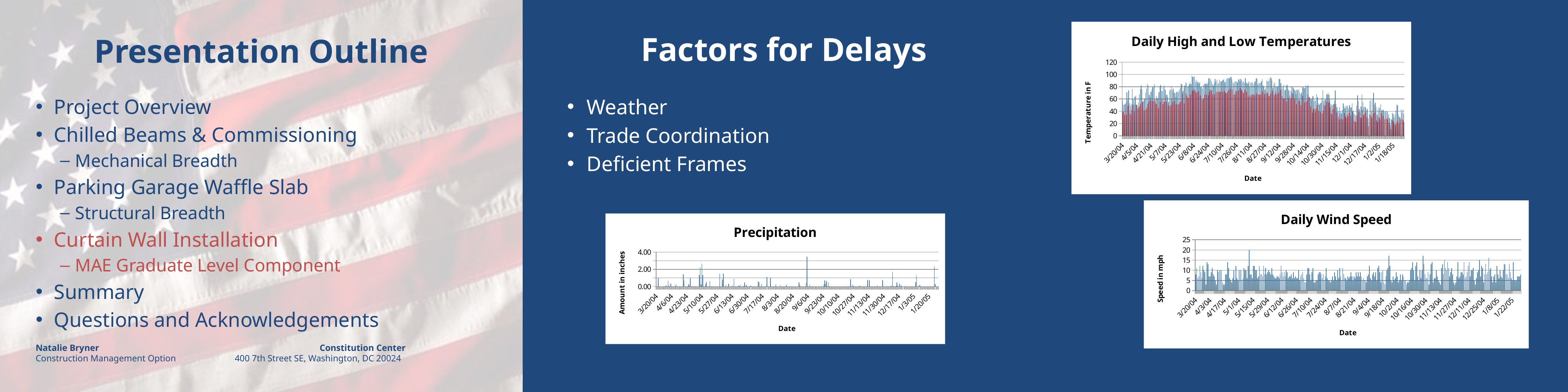
What kind of chart is the 'Daily Wind Speed' chart? bar chart In the 'Precipitation' chart, what is the y-axis title? Amount in inches In the 'Daily High and Low Temperatures' chart, is the highest daily high temperature greater or less than 80? greater In the 'Daily High and Low Temperatures' chart, what is the y-axis title? Temperature in F In the 'Daily High and Low Temperatures' chart, is the highest temperature plotted greater or less than 120? less In the 'Daily High and Low Temperatures' chart, do the daily high temperatures generally rise or fall from 8/27/04 to 1/18/05? fall In the 'Daily High and Low Temperatures' chart, do the daily high temperatures generally rise or fall from 3/20/04 to 7/10/04? rise In the 'Daily Wind Speed' chart, is the highest wind speed greater or less than 15? greater How many charts are shown on the slide? 3 What kind of chart is the 'Precipitation' chart? bar chart